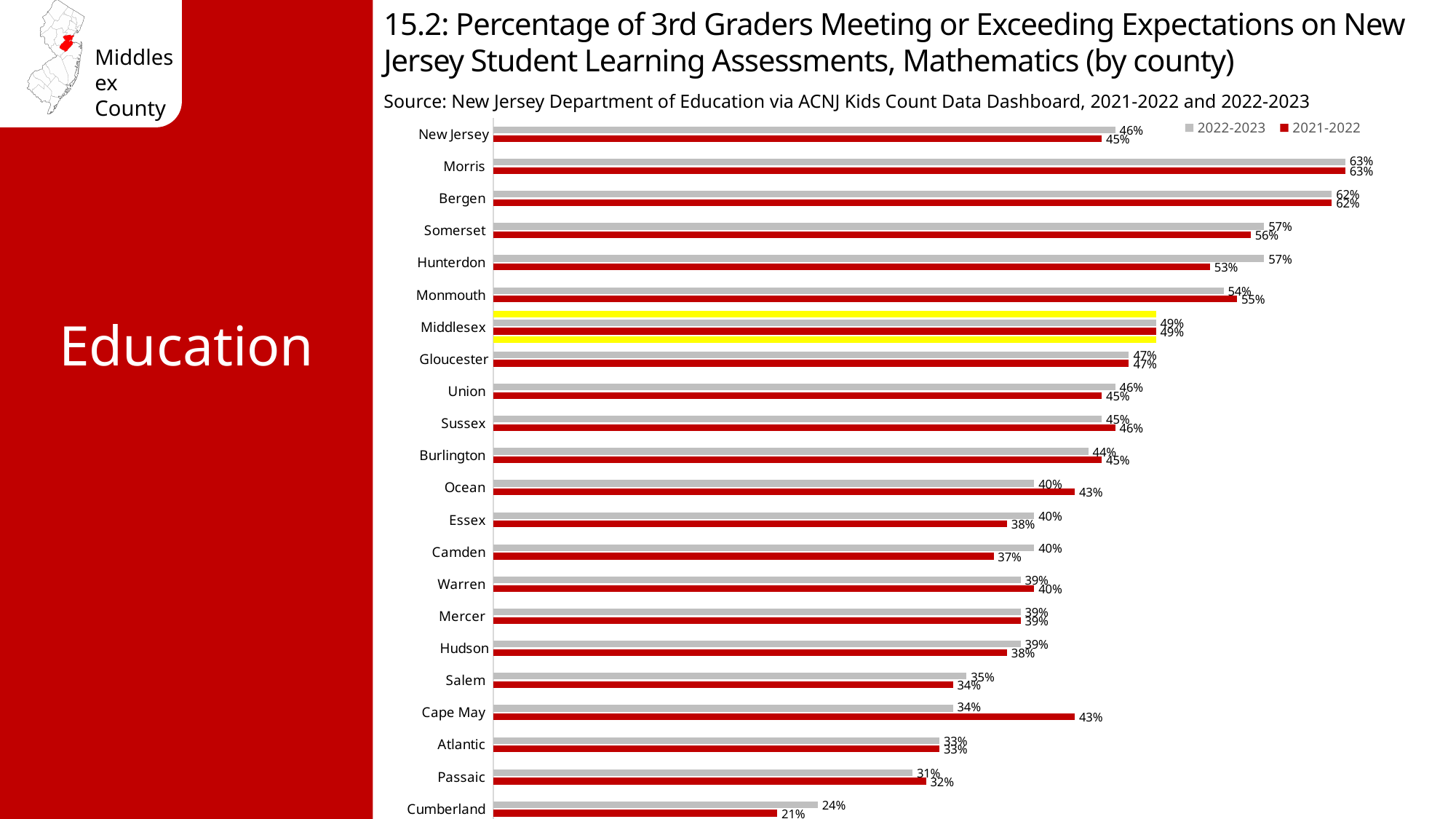
How many series does the legend list? 2 What is the value for Cape May in 2021-2022? 43% What is the value for Middlesex in 2022-2023? 49% For Cape May, which is larger: the 2022-2023 value or the 2021-2022 value? 2021-2022 What is the value for Cumberland in 2021-2022? 21% Which county has the highest value for 2022-2023? Morris What is the difference between Cape May's 2021-2022 value and its 2022-2023 value? 9 percentage points What is the difference between Hunterdon's 2022-2023 value and its 2021-2022 value? 4 percentage points Which county is highlighted in yellow on the chart? Middlesex How many categories (counties plus New Jersey) are shown on the chart? 22 What kind of chart is shown on the slide? Bar chart Which county has the lowest value for 2022-2023? Cumberland